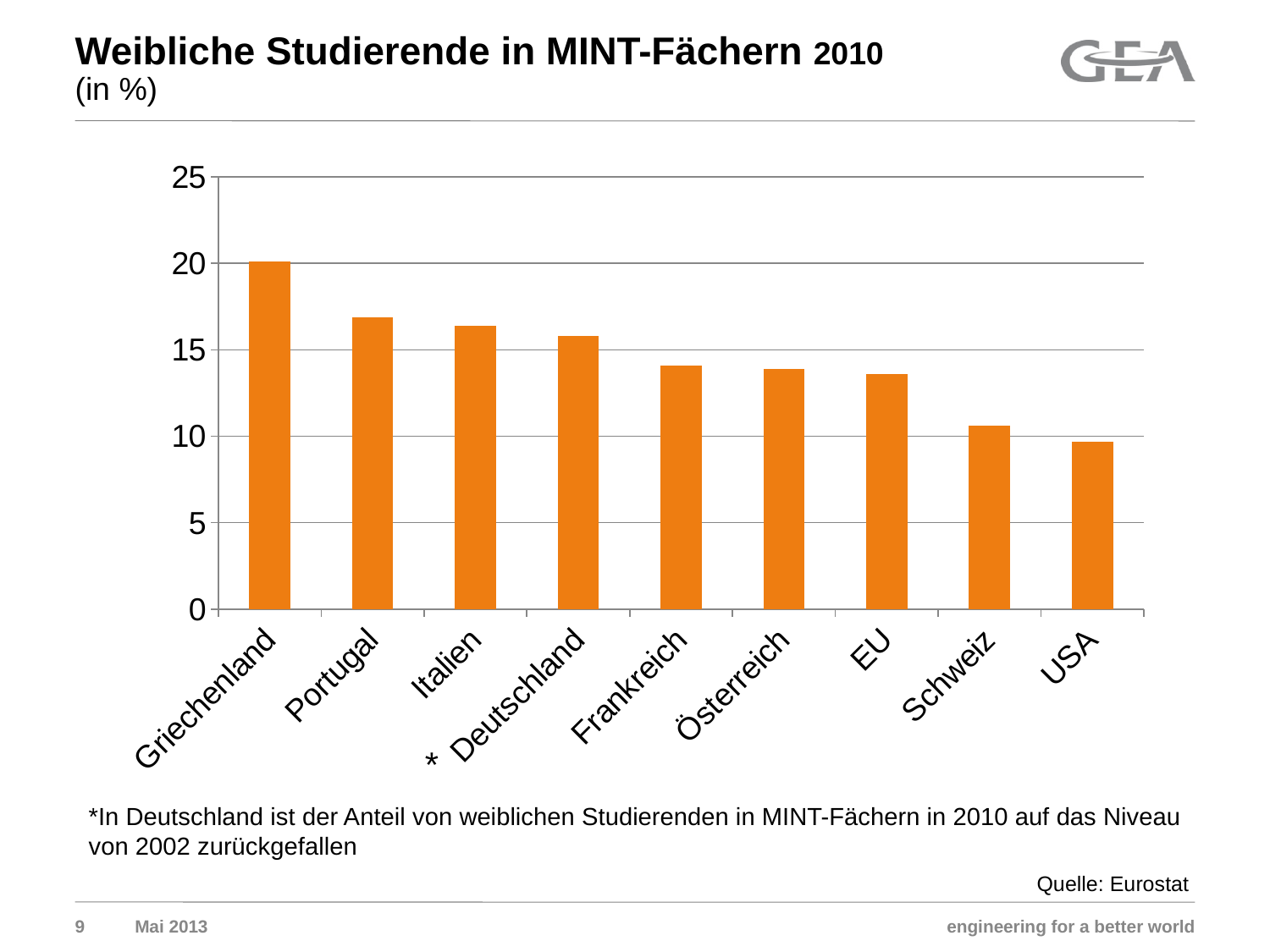
Which category has the highest share of female students in MINT subjects? Griechenland Which is larger, the value for USA or the value for Griechenland? Griechenland Is the value for Griechenland greater or less than 15? greater Is the value for EU greater or less than 10? greater What is the source cited for the chart data? Eurostat Is the value for Frankreich greater or less than 15? less Do the values rise or fall from left to right along the x axis? fall How many countries or regions are shown on the x axis of the chart? 9 Which category has the lowest share of female students in MINT subjects? USA What kind of chart is shown on the slide? bar chart Which is larger, the value for Portugal or the value for Schweiz? Portugal